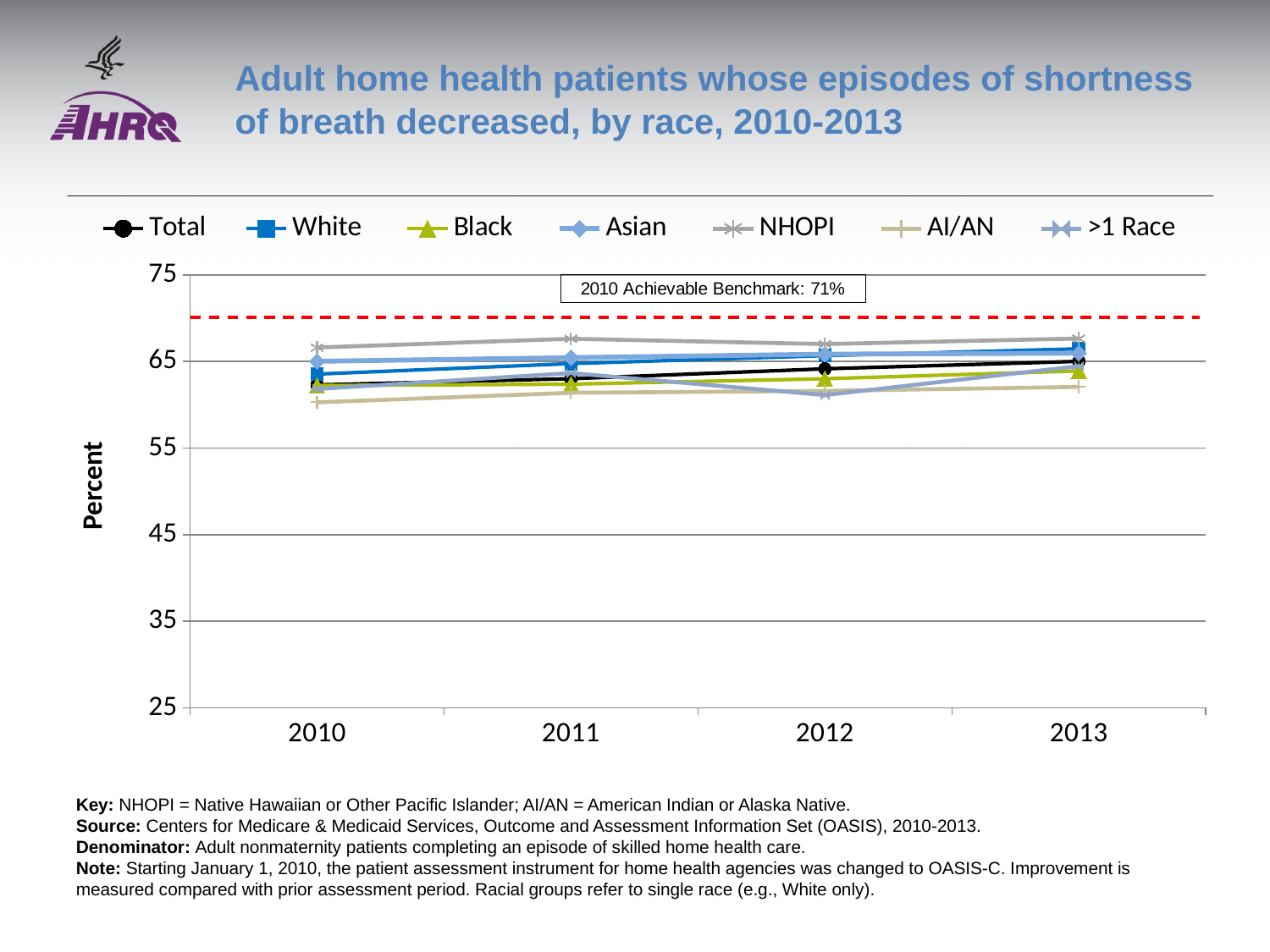
In 2010, which is larger: the value for NHOPI or the value for Black? NHOPI How many years are plotted along the x axis? 4 What is the label of the y axis? Percent How many series does the legend list? 7 What kind of chart is shown on the slide? Line chart Is the value for Total in 2010 greater or less than 65? less Is the value for NHOPI in 2013 greater or less than 65? greater Which racial group has the highest value in 2011? NHOPI Does the Total series rise or fall from 2010 to 2013? Rise Is the value for AI/AN in 2010 greater or less than 65? less Which racial group has the lowest value in 2010? AI/AN What is the 2010 Achievable Benchmark value shown on the chart? 71%